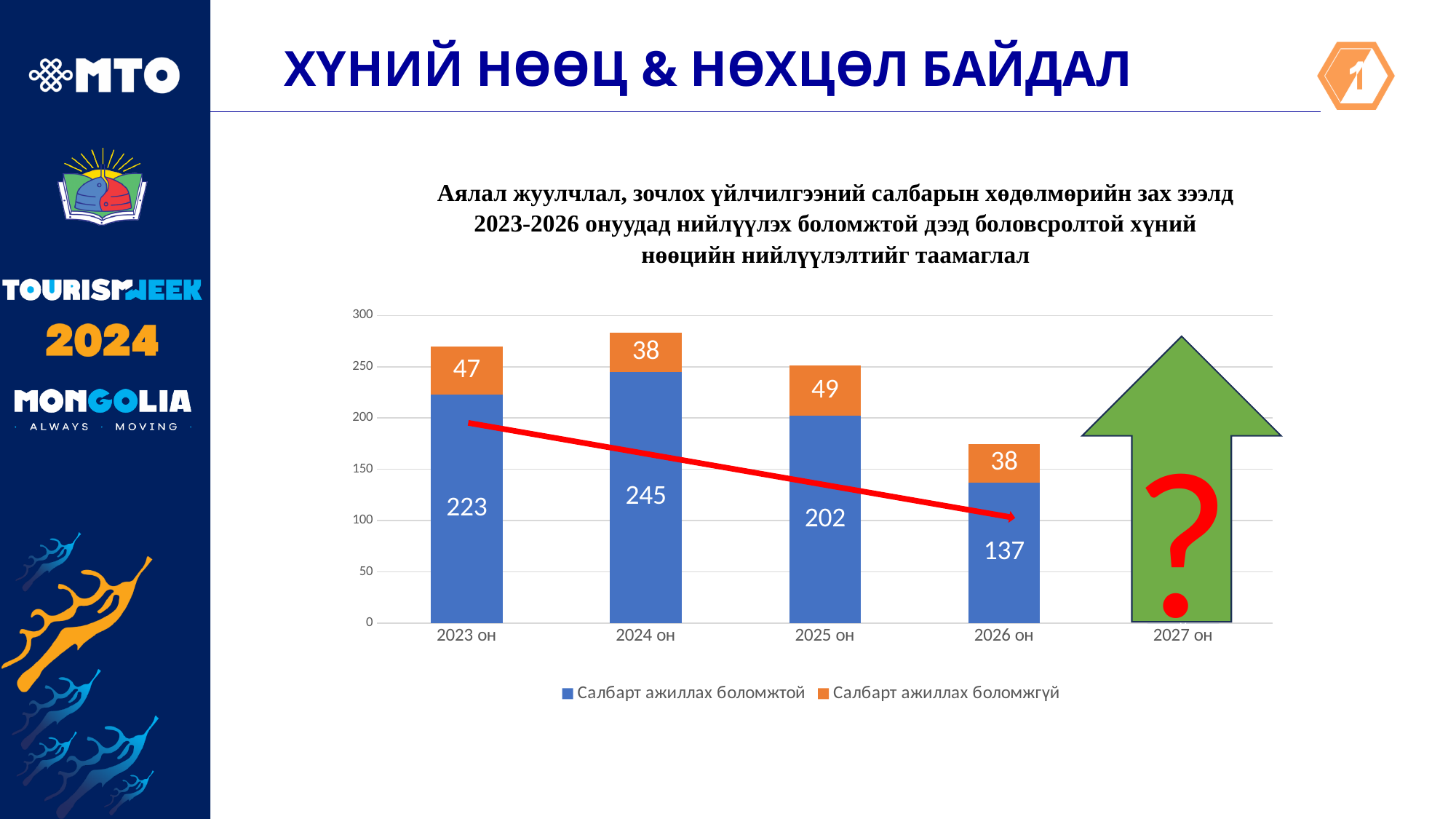
How many series does the legend list? 2 Which year has the lowest value for "Салбарт ажиллах боломжтой"? 2026 он What is the value of "Салбарт ажиллах боломжгүй" for 2025 он? 49 What is the total of the stacked bar for 2023 он? 270 What is the total of the stacked bar for 2025 он? 251 Which is larger: the "Салбарт ажиллах боломжгүй" value for 2023 он or for 2024 он? 2023 он What is the value of "Салбарт ажиллах боломжтой" for 2023 он? 223 What is the value of "Салбарт ажиллах боломжтой" for 2026 он? 137 Which year has the highest value for "Салбарт ажиллах боломжтой"? 2024 он What kind of chart is shown on the slide? Stacked bar chart What is the difference between the "Салбарт ажиллах боломжтой" values for 2024 он and 2026 он? 108 Does the "Салбарт ажиллах боломжтой" value rise or fall from 2024 он to 2026 он? Fall